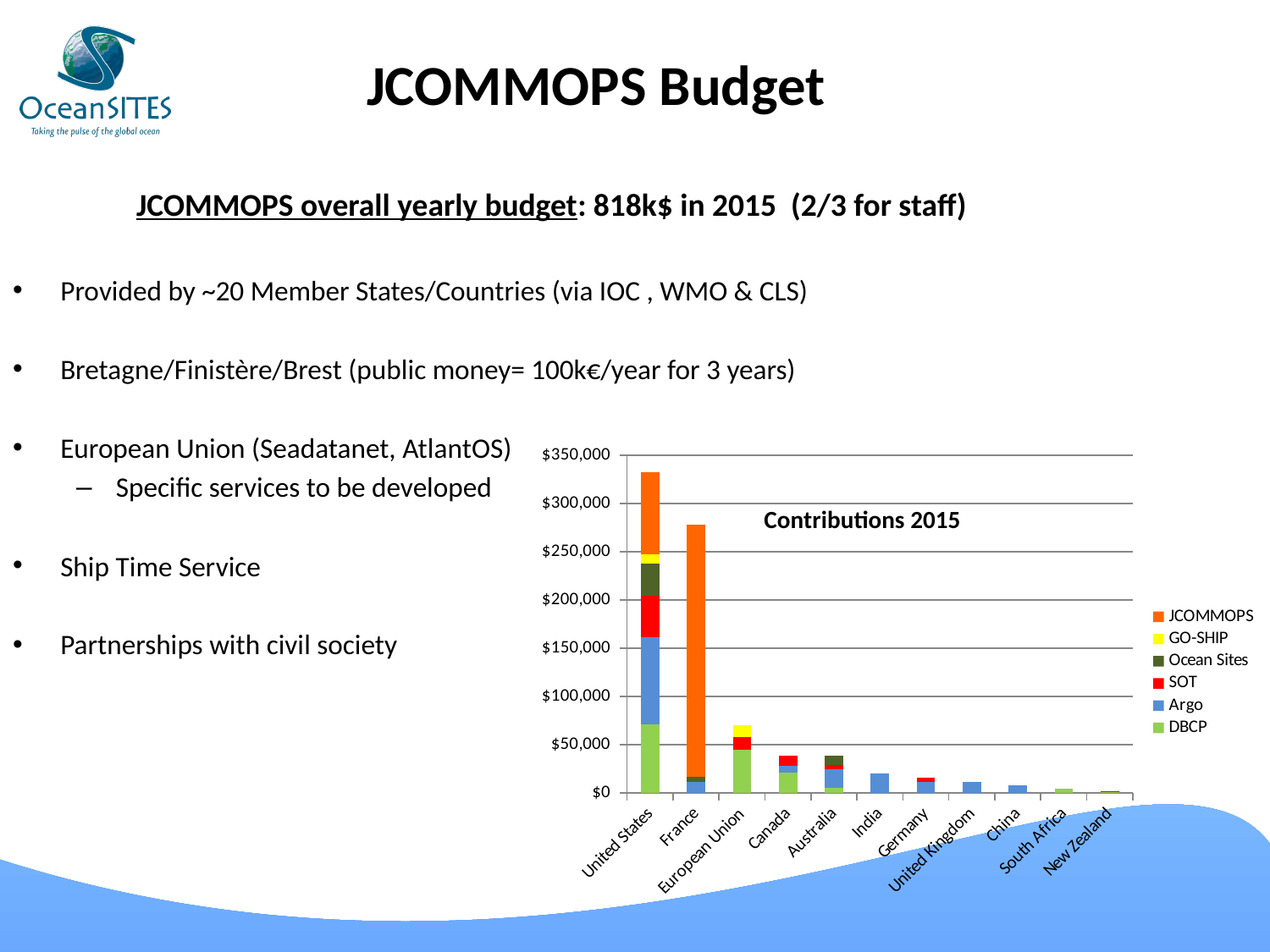
Is the total contribution for India greater or less than $50,000? less What type of chart is shown on the slide? Stacked bar chart Do the total contributions rise or fall moving from left to right along the x axis? fall Is the total contribution for the United States greater or less than $300,000? greater Which has a larger total contribution, the United States or France? United States What is the title of the chart? Contributions 2015 Which country has the lowest total contribution in the chart? New Zealand How many series does the chart legend list? 6 Which country has the highest total contribution in the chart? United States Is the total contribution for the European Union greater or less than $50,000? greater How many countries/categories are shown on the x axis of the chart? 11